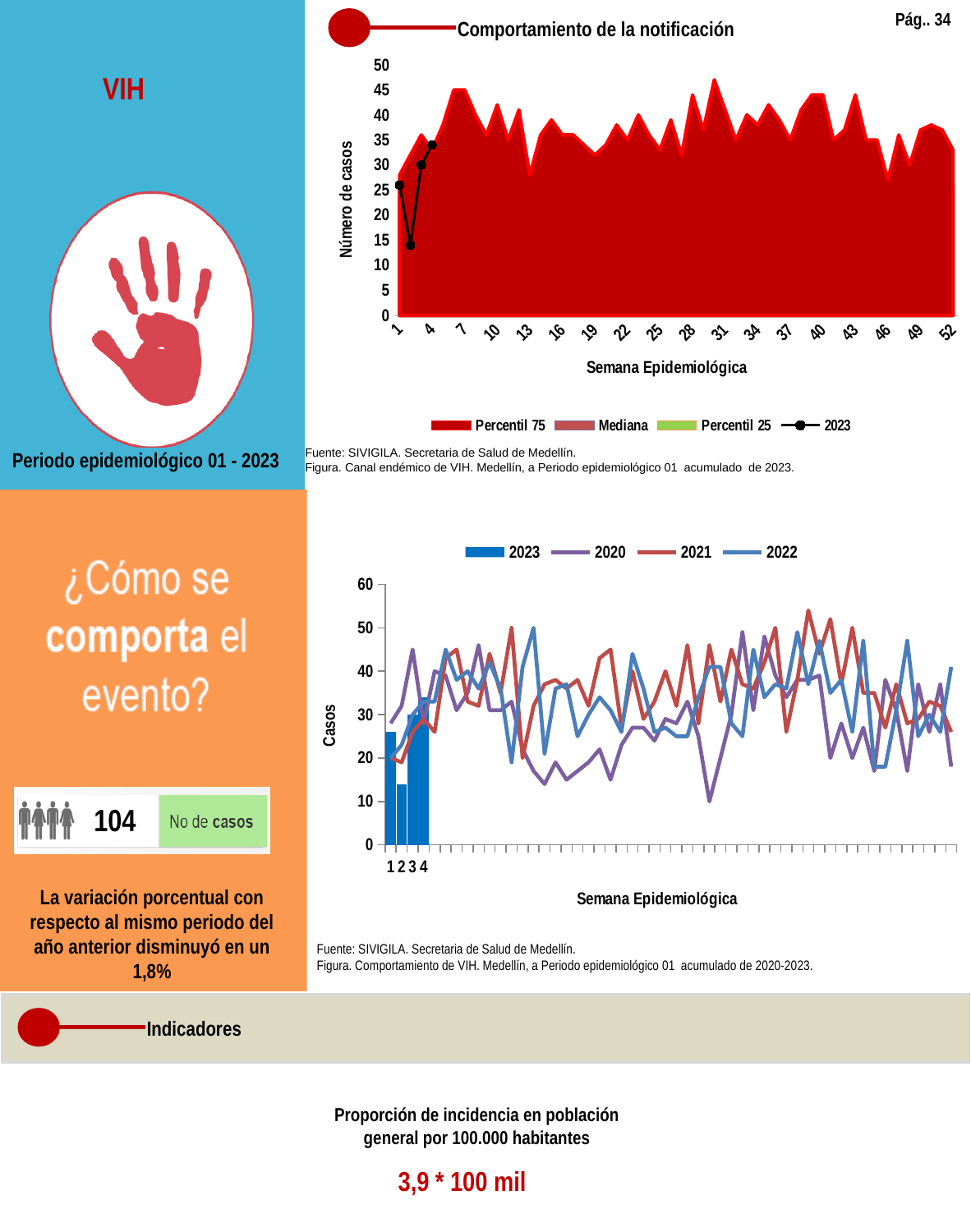
In the top chart 'Comportamiento de la notificación', is the 2023 value for week 2 greater or less than 20? less In the bottom chart, how many series does the legend list? 4 In the top chart 'Comportamiento de la notificación', how many data points are plotted for the 2023 series? 4 In the bottom chart, what kind of chart is used to show the 2023 series? bar chart In the top chart 'Comportamiento de la notificación', which week has the lowest 2023 value? Week 2 In the top chart 'Comportamiento de la notificación', how many series does the legend list? 4 In the top chart 'Comportamiento de la notificación', what is the highest value shown on the vertical axis? 50 In the top chart 'Comportamiento de la notificación', does the 2023 line rise or fall from week 2 to week 4? rise In the bottom chart, is the 2023 value for week 2 greater or less than 20? less In the top chart 'Comportamiento de la notificación', is the 2023 value for week 4 greater or less than 30? greater In the bottom chart, which of the four 2023 weeks has the lowest value? Week 2 In the top chart 'Comportamiento de la notificación', what is the title of the vertical axis? Número de casos